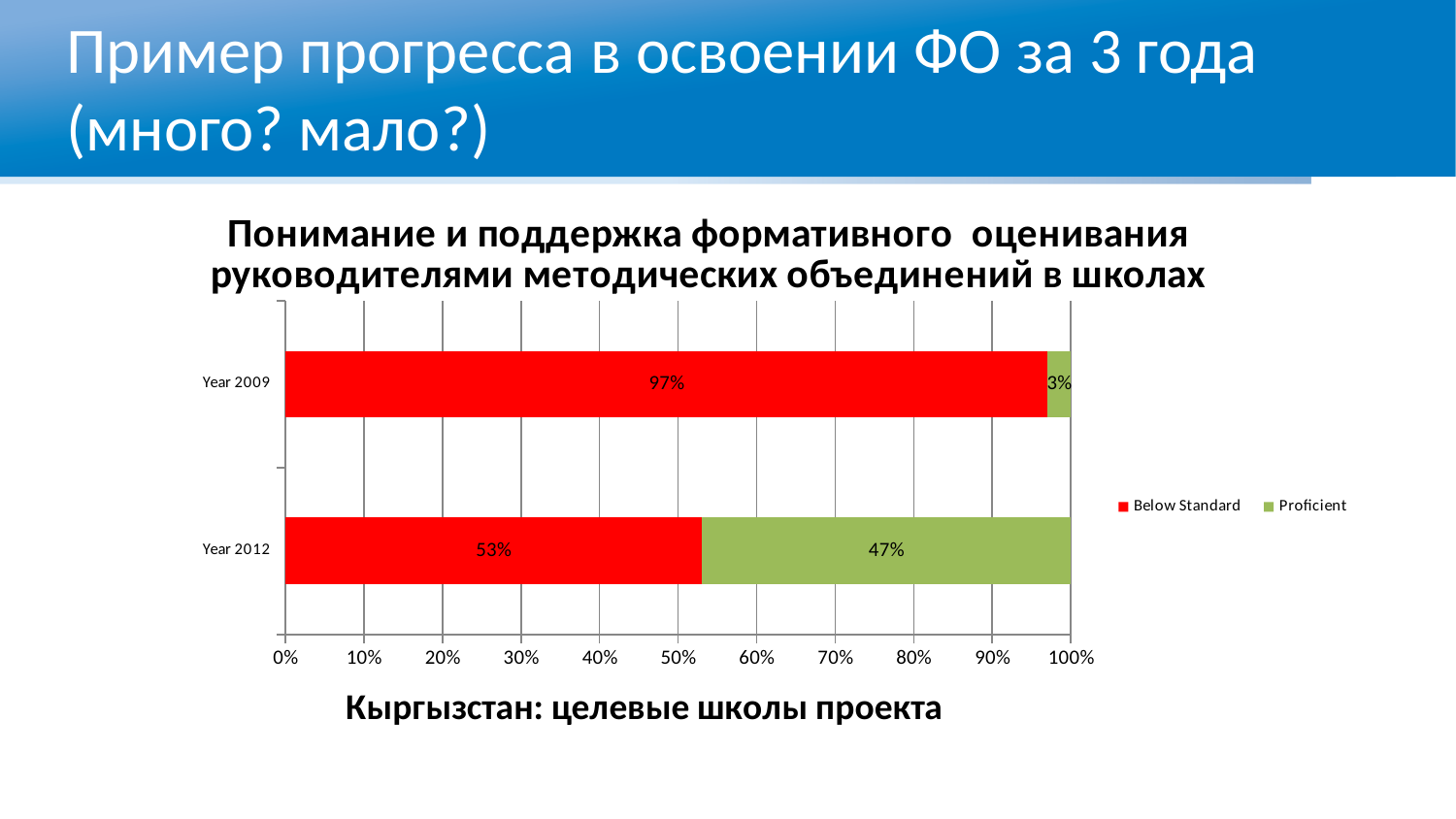
What is the Proficient value for Year 2012? 47% Which year has the higher Proficient value? Year 2012 Is the Below Standard value for Year 2012 larger than the Proficient value for Year 2012? Yes What is the difference between the Below Standard values for Year 2009 and Year 2012? 44% What kind of chart is shown on the slide? Stacked bar chart How many series does the legend list? 2 Which year has the lower Below Standard value? Year 2012 What is the Proficient value for Year 2009? 3% What is the Below Standard value for Year 2012? 53% What is the Below Standard value for Year 2009? 97% How many categories (years) are shown on the chart? 2 What colour represents the Proficient series? Green